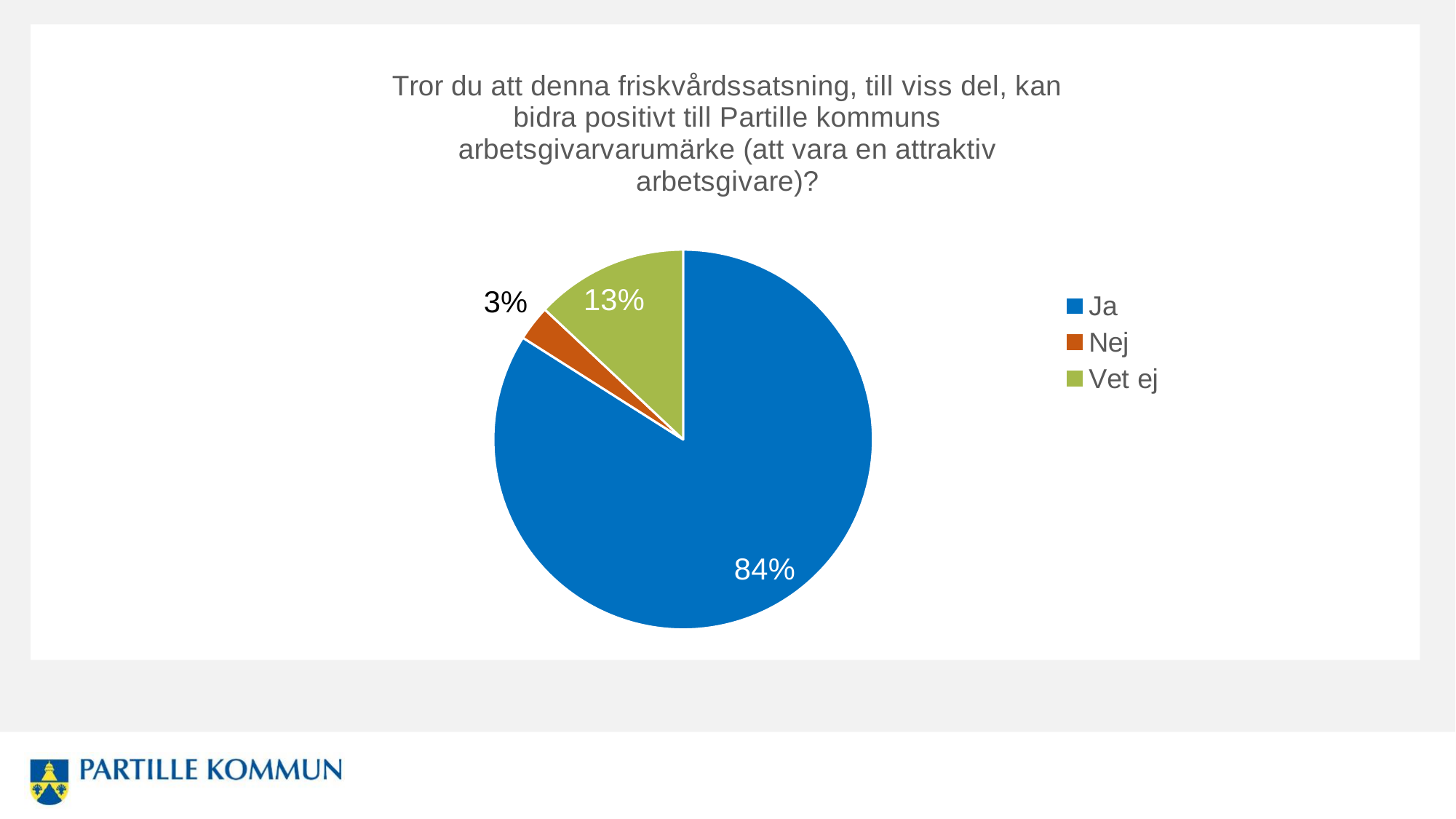
What percentage of respondents answered "Ja"? 84% What type of chart is shown on the slide? pie chart How many percentage points larger is the "Vet ej" share than the "Nej" share? 10 How many entries does the legend list? 3 How many slices does the pie chart have? 3 What colour is the "Vet ej" slice? green Which is larger, the share for "Nej" or the share for "Vet ej"? Vet ej What percentage of respondents answered "Nej"? 3% How many percentage points larger is the "Ja" share than the "Vet ej" share? 71 Which response has the largest share of the pie? Ja What percentage of respondents answered "Vet ej"? 13% Which response has the smallest share of the pie? Nej